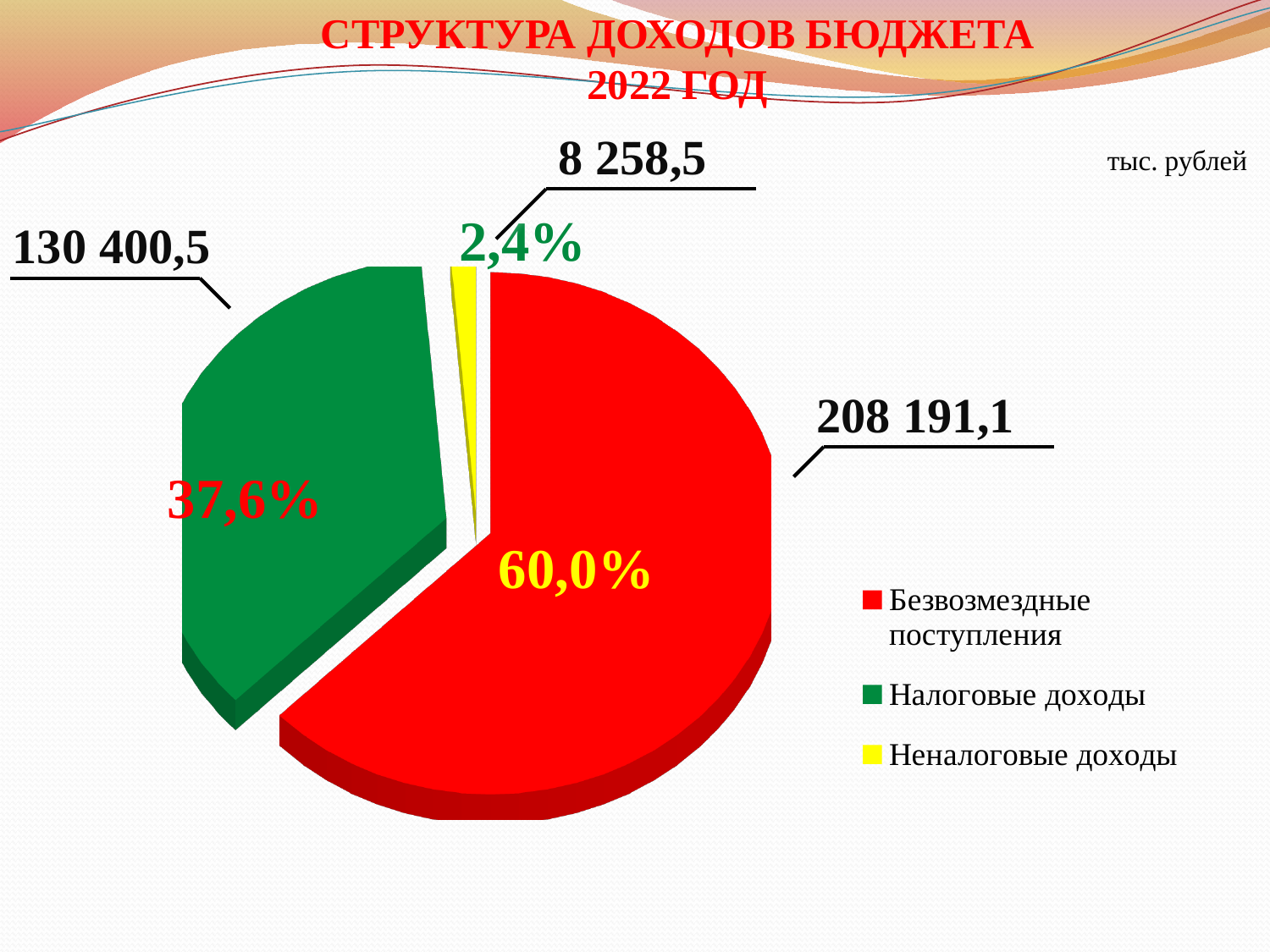
What share of the pie does Неналоговые доходы represent? 2,4% Which is larger, Налоговые доходы or Неналоговые доходы? Налоговые доходы What kind of chart is shown on the slide? Pie chart What share of the pie does Безвозмездные поступления represent? 60,0% What share of the pie does Налоговые доходы represent? 37,6% How many categories does the pie chart show? 3 What is the value for Неналоговые доходы? 8 258,5 Which category has the largest slice of the pie? Безвозмездные поступления What is the value for Безвозмездные поступления? 208 191,1 What is the value for Налоговые доходы? 130 400,5 Which category has the smallest slice of the pie? Неналоговые доходы What is the difference between the values for Безвозмездные поступления and Налоговые доходы? 77 790,6